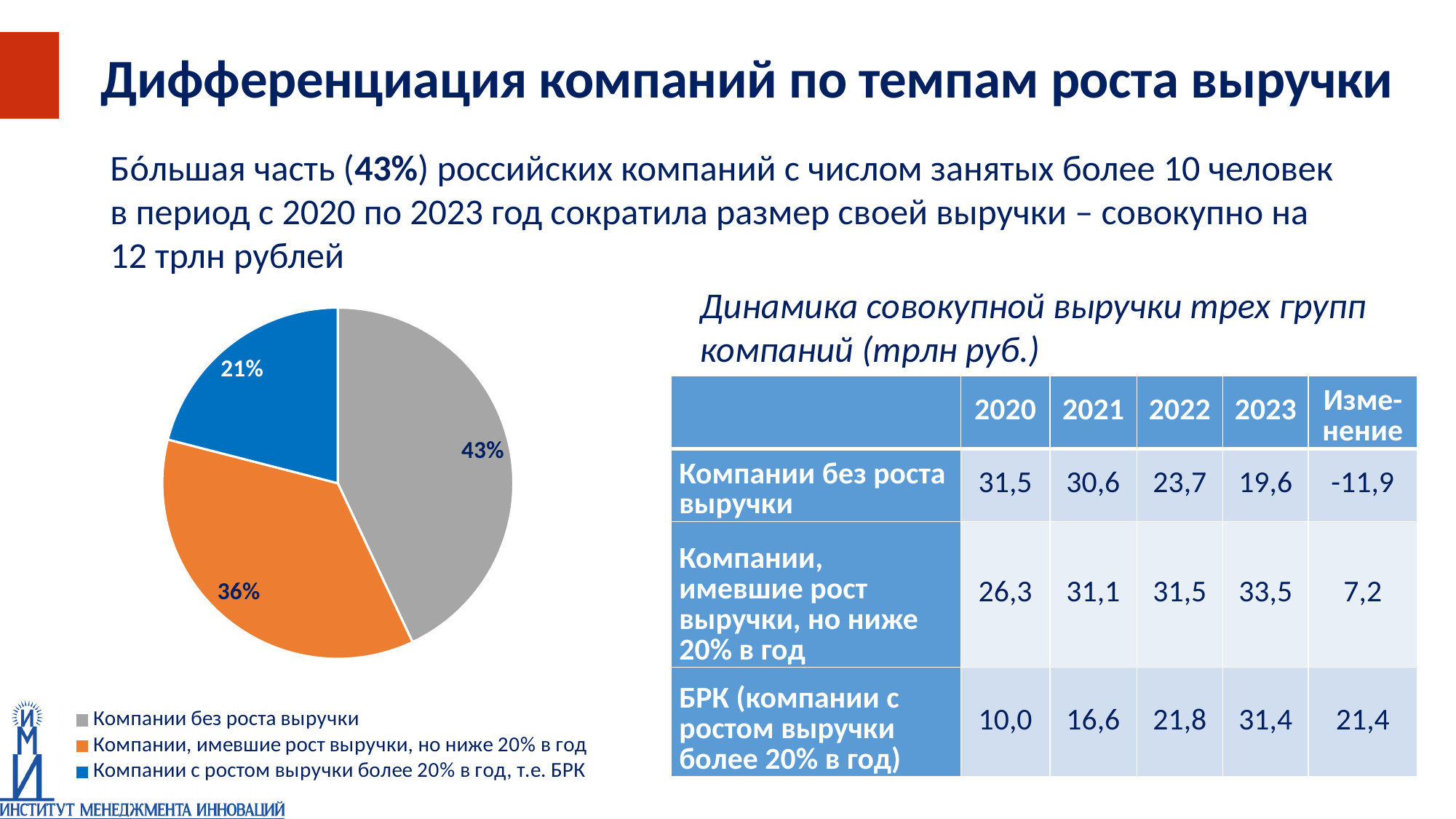
What share of the pie is 'Компании с ростом выручки более 20% в год, т.е. БРК'? 21% How many entries does the pie chart legend list? 3 What kind of chart is shown on the slide? pie chart Which slice is larger: 'Компании без роста выручки' or 'Компании, имевшие рост выручки, но ниже 20% в год'? Компании без роста выручки What share of the pie is 'Компании без роста выручки'? 43% What colour is the slice for БРК in the pie chart? blue Which category has the smallest slice of the pie chart? Компании с ростом выручки более 20% в год, т.е. БРК What share of the pie is 'Компании, имевшие рост выручки, но ниже 20% в год'? 36% What colour is the slice for 'Компании без роста выручки' in the pie chart? grey Which category has the largest slice of the pie chart? Компании без роста выручки How many slices does the pie chart have? 3 What is the difference in percentage points between the slice for 'Компании без роста выручки' and the slice for БРК? 22